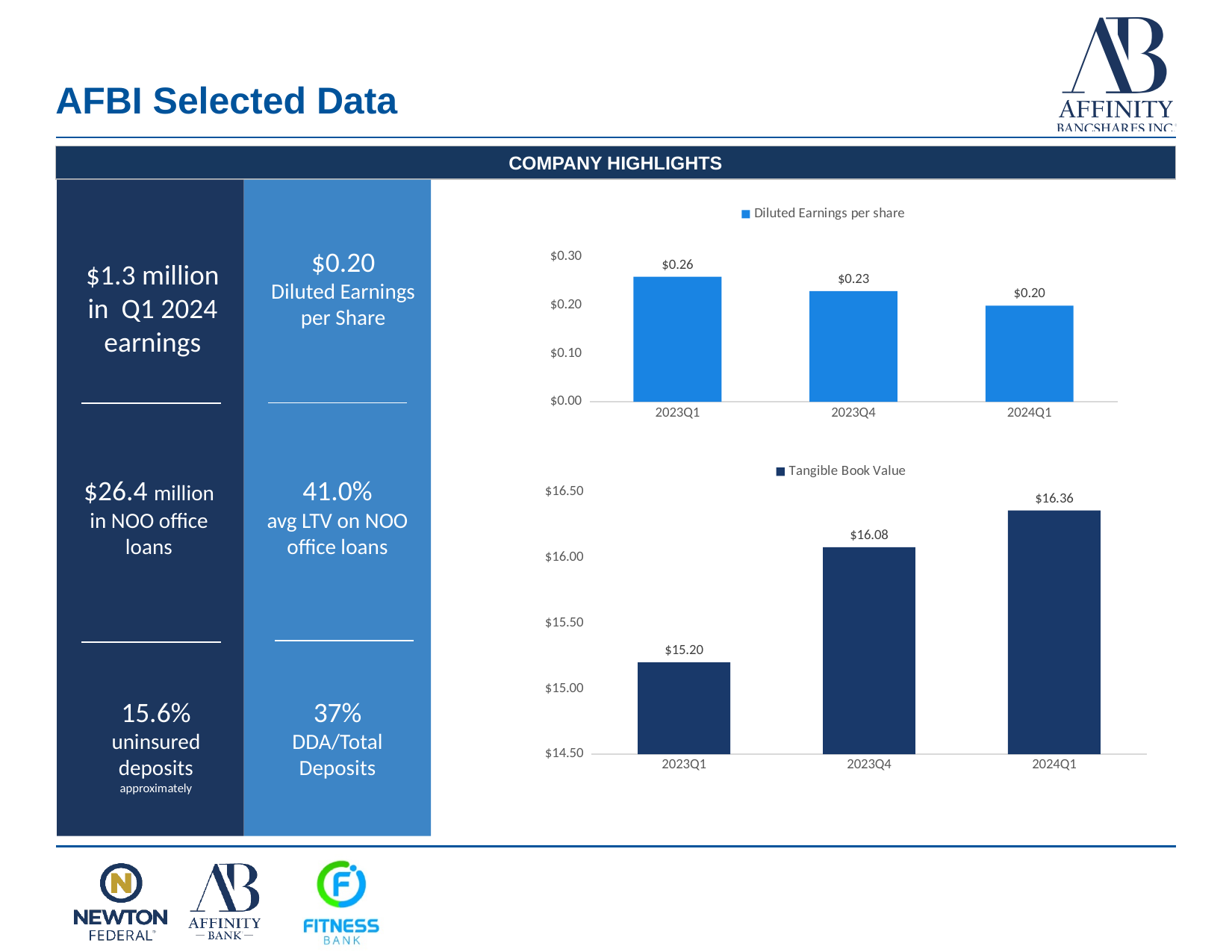
In the Diluted Earnings per share chart, which quarter has the highest value? 2023Q1 In the Diluted Earnings per share chart, what is the value for 2023Q4? $0.23 In the Diluted Earnings per share chart, how many quarters are plotted? 3 In the Tangible Book Value chart, is the value for 2023Q4 larger or smaller than the value for 2023Q1? larger In the Tangible Book Value chart, which quarter has the lowest value? 2023Q1 What kind of chart is the Tangible Book Value chart? bar chart How many series does the legend of the Diluted Earnings per share chart list? 1 In the Tangible Book Value chart, what is the difference between 2024Q1 and 2023Q4? $0.28 In the Diluted Earnings per share chart, do the values rise or fall from 2023Q1 to 2024Q1? fall In the Diluted Earnings per share chart, what is the difference between 2023Q1 and 2024Q1? $0.06 In the Tangible Book Value chart, do the values rise or fall from 2023Q1 to 2024Q1? rise In the Tangible Book Value chart, what is the value for 2024Q1? $16.36